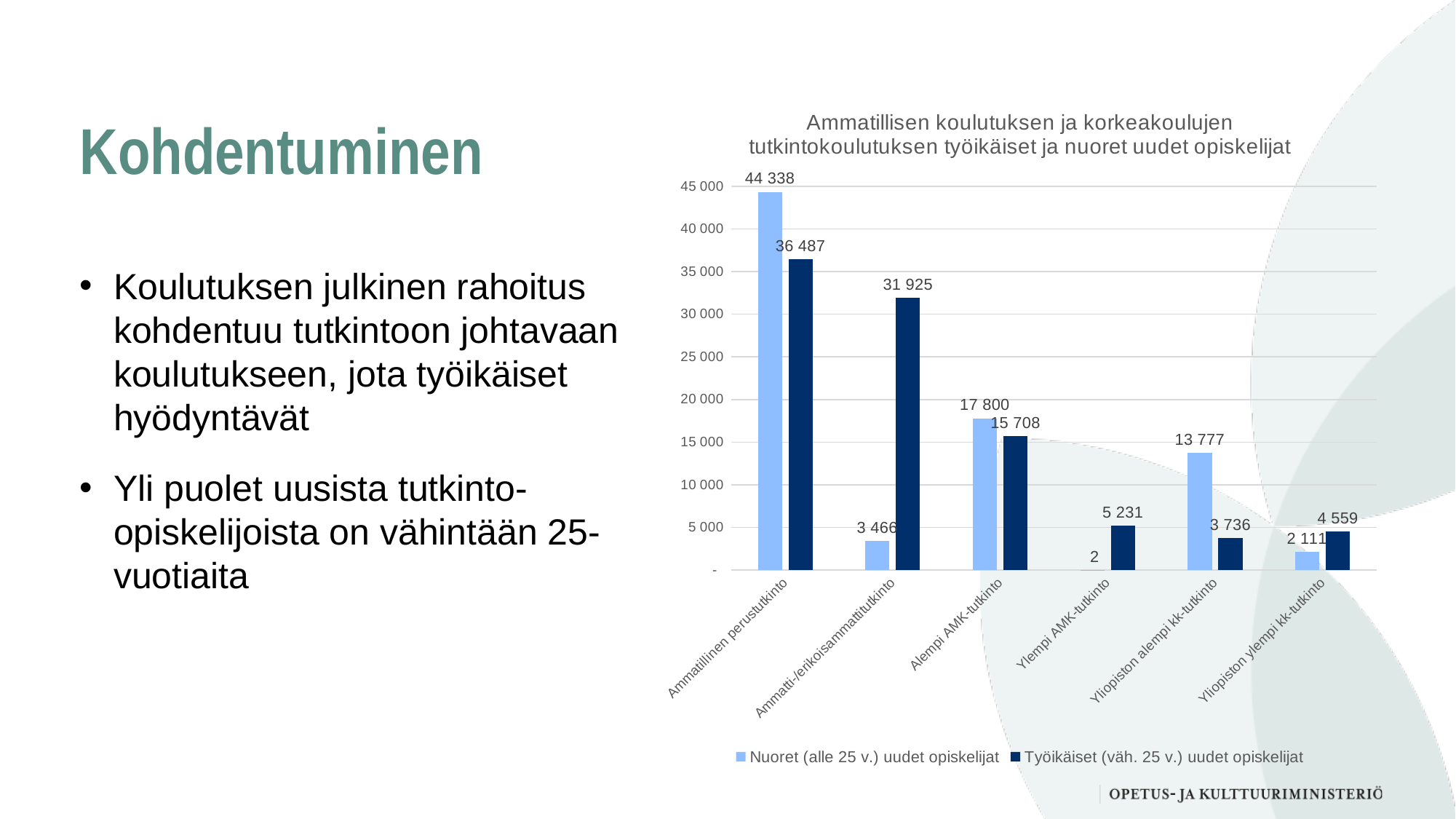
What kind of chart is shown on the slide? Bar chart What is the value for Nuoret (alle 25 v.) uudet opiskelijat in the Ammatillinen perustutkinto category? 44 338 What is the difference between the Työikäiset and Nuoret values in the Ammatti-/erikoisammattitutkinto category? 28 459 Which category has the lowest value for Nuoret (alle 25 v.) uudet opiskelijat? Ylempi AMK-tutkinto What is the difference between the Nuoret and Työikäiset values in the Ammatillinen perustutkinto category? 7 851 In the Alempi AMK-tutkinto category, which series has the larger value: Nuoret (alle 25 v.) or Työikäiset (väh. 25 v.)? Nuoret (alle 25 v.) uudet opiskelijat What is the value for Nuoret (alle 25 v.) uudet opiskelijat in the Yliopiston alempi kk-tutkinto category? 13 777 Which category has the highest value for Työikäiset (väh. 25 v.) uudet opiskelijat? Ammatillinen perustutkinto How many series does the legend list? 2 How many categories are shown on the x axis? 6 What is the value for Työikäiset (väh. 25 v.) uudet opiskelijat in the Yliopiston ylempi kk-tutkinto category? 4 559 What is the value for Työikäiset (väh. 25 v.) uudet opiskelijat in the Ammatti-/erikoisammattitutkinto category? 31 925